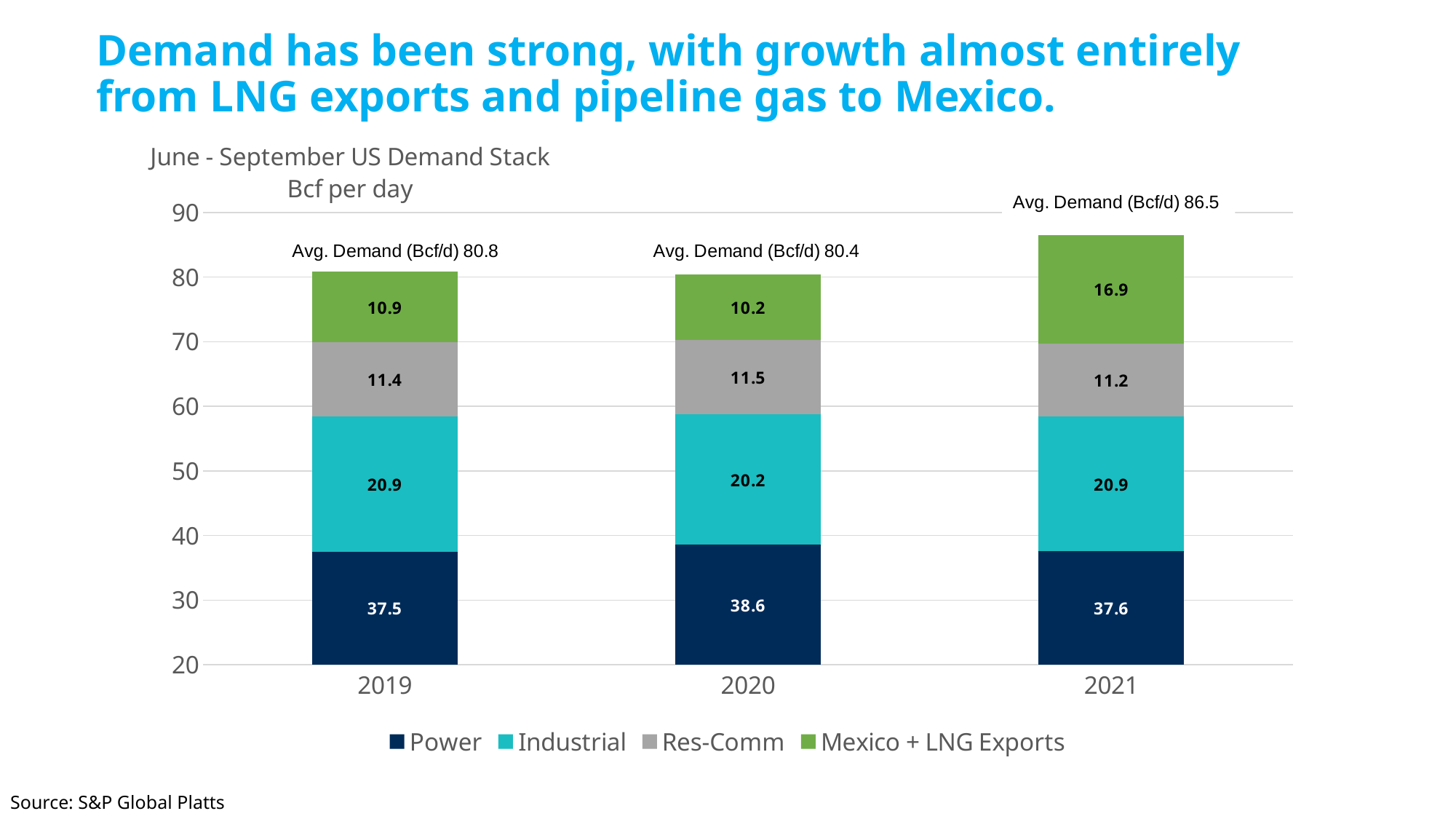
Which year has the highest Mexico + LNG Exports value? 2021 What is the Res-Comm value for 2019? 11.4 Which year has the lowest Avg. Demand (Bcf/d)? 2020 How many series does the legend list? 4 What is the difference between the Mexico + LNG Exports values for 2021 and 2020? 6.7 What is the chart's title? June - September US Demand Stack What is the Mexico + LNG Exports value for 2021? 16.9 Which is larger, the Industrial value for 2019 or for 2020? 2019 What Avg. Demand (Bcf/d) is shown above the 2021 bar? 86.5 What is the Power value for 2020? 38.6 How many years are shown on the x axis? 3 What kind of chart is shown? Stacked bar chart